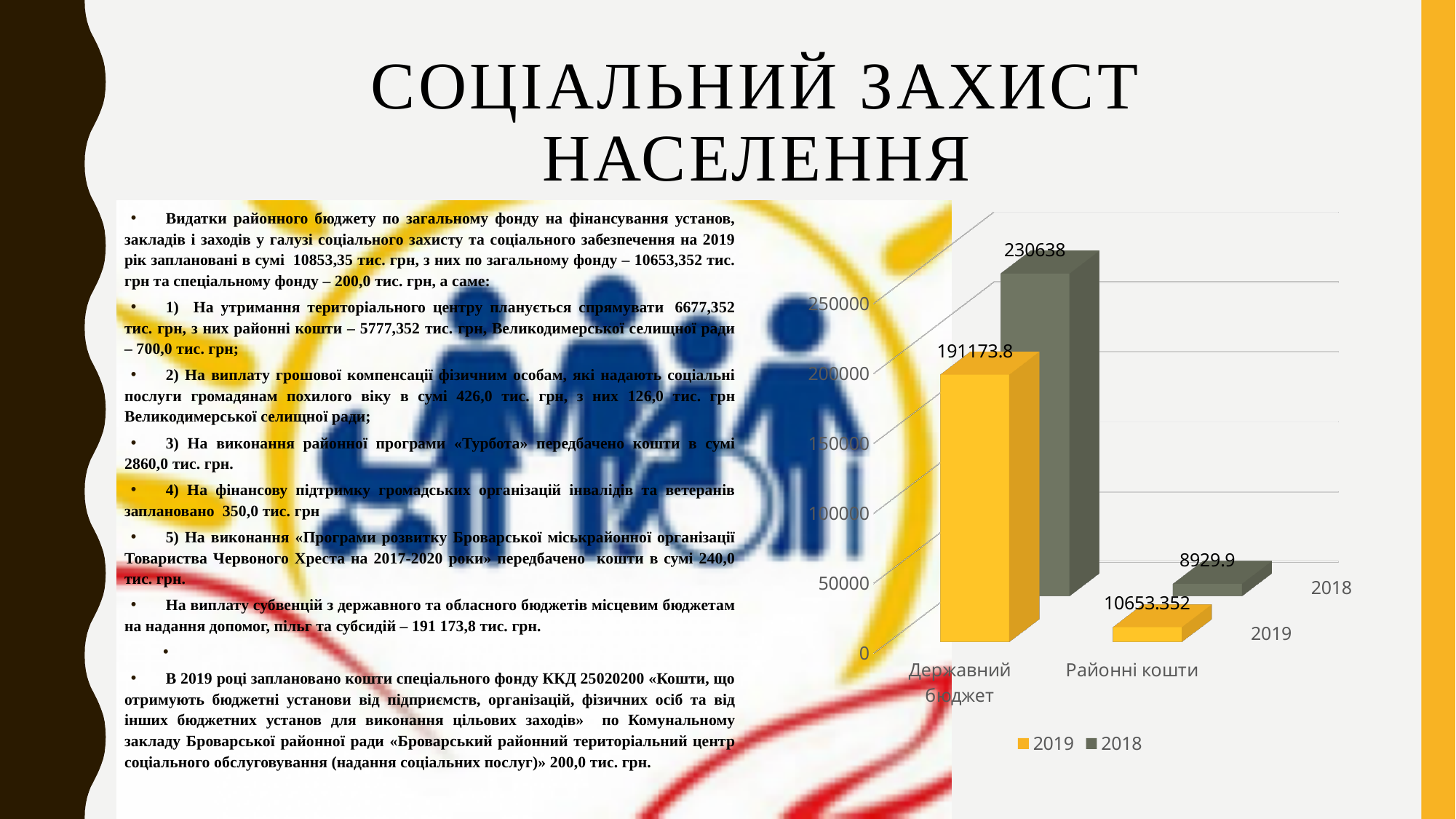
What is the value for Районні кошти in the 2019 series? 10653.352 What is the difference between the 2018 and 2019 values for Державний бюджет? 39464.2 What is the value for Державний бюджет in the 2019 series? 191173.8 What is the value for Державний бюджет in the 2018 series? 230638 How many series does the chart legend list? 2 Is the 2019 value for Державний бюджет greater or less than 200000? less Which category has the lowest value in the 2019 series? Районні кошти Which category has the highest value in the 2018 series? Державний бюджет What type of chart is shown on the slide? bar chart For Районні кошти, which series has the larger value, 2019 or 2018? 2019 How many categories are shown on the x axis of the chart? 2 What is the value for Районні кошти in the 2018 series? 8929.9